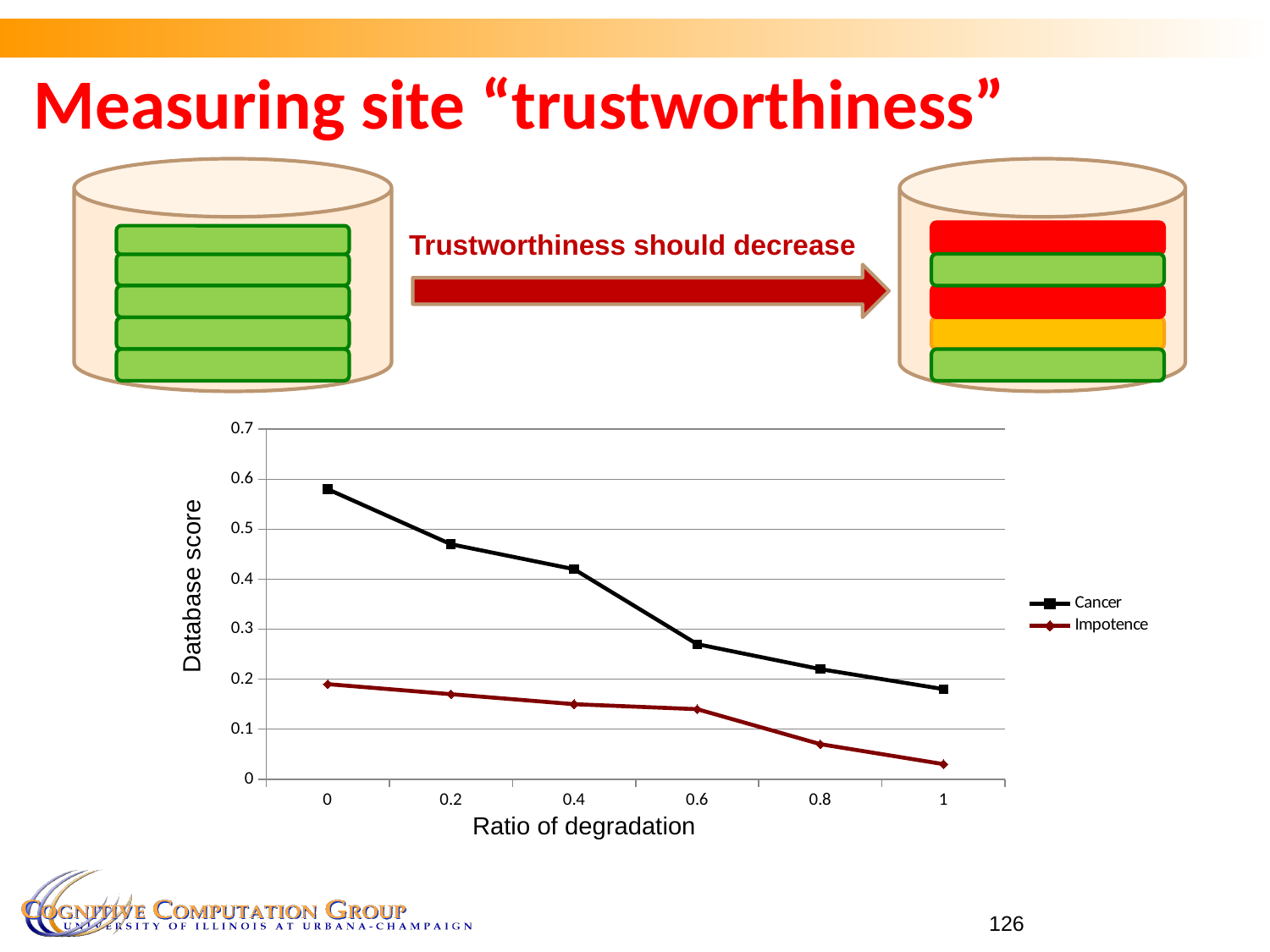
Is the Impotence value at a ratio of degradation of 1 greater or less than 0.1? less What kind of chart is shown on the slide? line chart Does the Cancer series rise or fall as the ratio of degradation increases? fall Does the Impotence series rise or fall as the ratio of degradation increases? fall Is the Impotence value at a ratio of degradation of 0 greater or less than 0.1? greater How many series does the chart legend list? 2 Which series has the higher database score at a ratio of degradation of 0, Cancer or Impotence? Cancer Is the Cancer value at a ratio of degradation of 0 greater or less than 0.5? greater How many points along the x axis are plotted for each series? 6 What is the title of the x axis? Ratio of degradation What is the title of the y axis? Database score